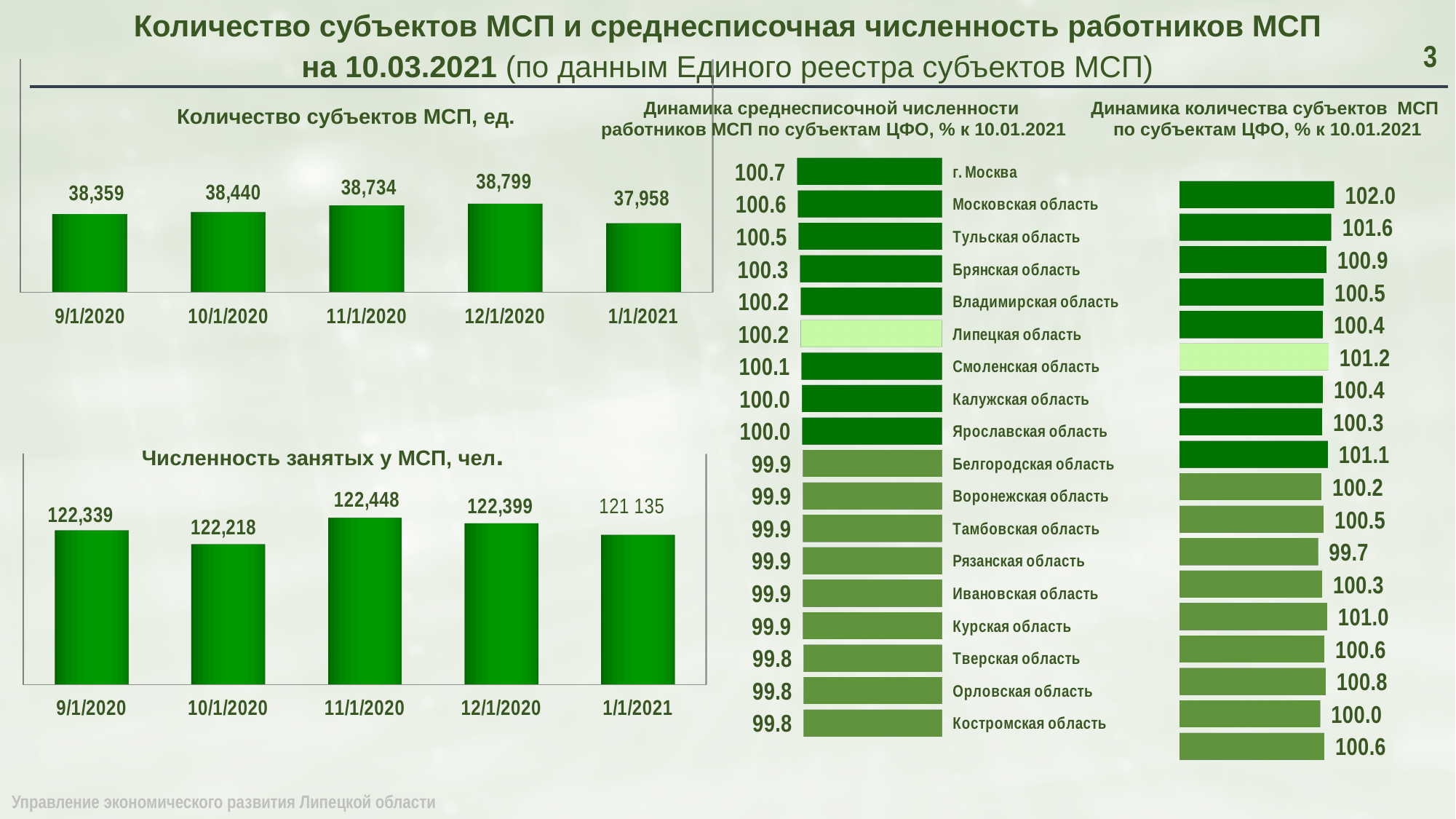
How many regions are listed in the chart 'Динамика среднесписочной численности работников МСП по субъектам ЦФО'? 18 How many dates are shown in the chart 'Количество субъектов МСП, ед.'? 5 In the chart 'Количество субъектов МСП, ед.', which date has the lowest value? 1/1/2021 In the chart 'Количество субъектов МСП, ед.', what is the value for 12/1/2020? 38,799 In the chart 'Количество субъектов МСП, ед.', what is the difference between the values for 12/1/2020 and 1/1/2021? 841 In the chart 'Численность занятых у МСП, чел.', what is the value for 11/1/2020? 122,448 In the chart 'Динамика среднесписочной численности работников МСП по субъектам ЦФО', which region has the highest value? г. Москва In the chart 'Динамика среднесписочной численности работников МСП по субъектам ЦФО', what is the value for Липецкая область? 100.2 In the chart 'Численность занятых у МСП, чел.', which date has the highest value? 11/1/2020 In the chart 'Численность занятых у МСП, чел.', which is larger: the value for 9/1/2020 or 10/1/2020? 9/1/2020 What type of chart is 'Численность занятых у МСП, чел.'? bar chart In the chart 'Динамика среднесписочной численности работников МСП по субъектам ЦФО', which region's bar is highlighted in a lighter colour? Липецкая область